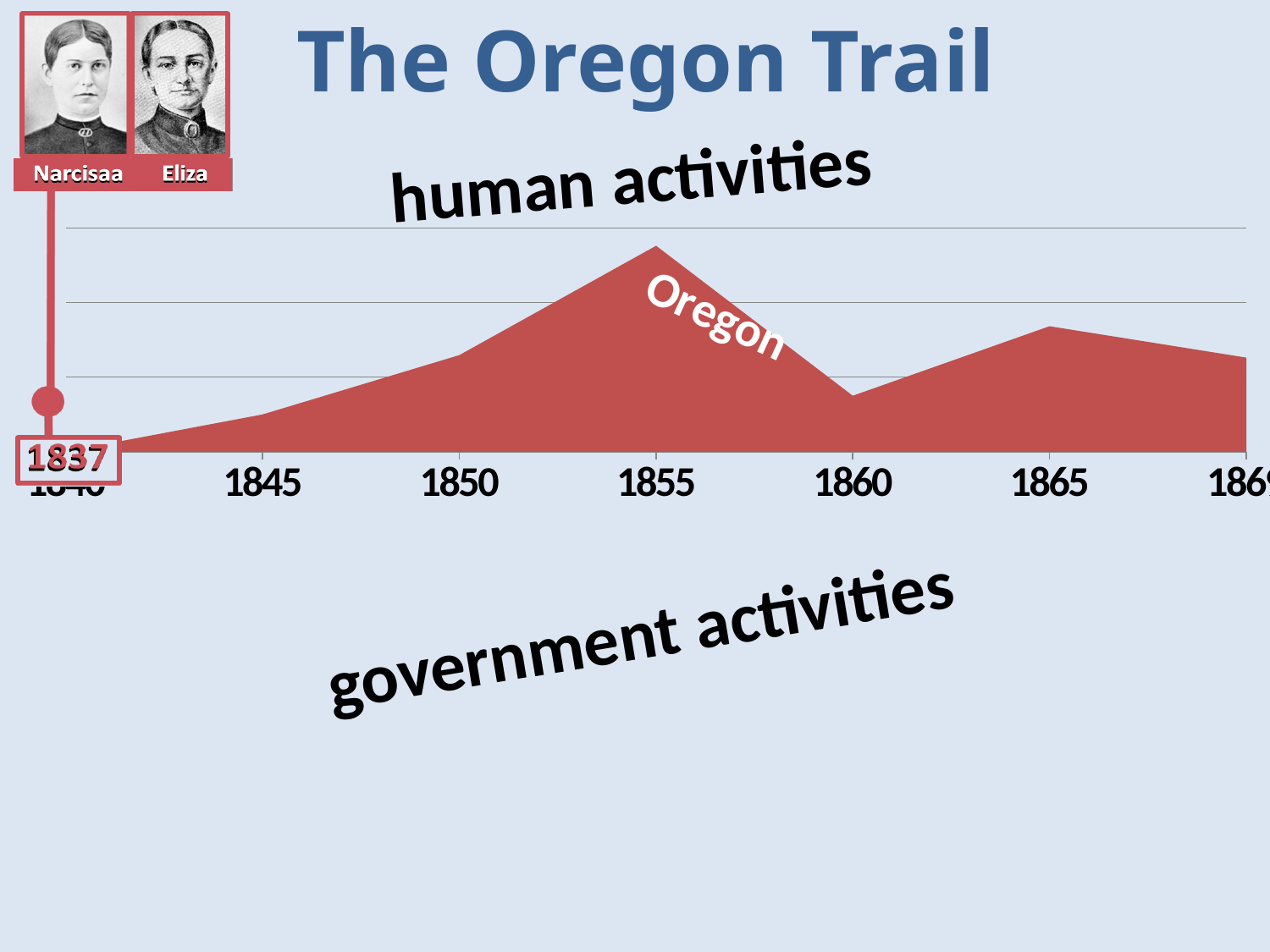
Does the Oregon series rise or fall between 1855 and 1860? fall Which year has the larger value for the Oregon series, 1845 or 1860? 1860 Which year has the larger value for the Oregon series, 1855 or 1865? 1855 What is the name of the series plotted in the area chart? Oregon Does the Oregon series rise or fall between 1860 and 1865? rise Does the Oregon series rise or fall between 1840 and 1855? rise Which year has the larger value for the Oregon series, 1860 or 1865? 1865 What kind of chart is shown on the slide? area chart What is the title of the slide containing the chart? The Oregon Trail In which year does the Oregon series reach its highest value? 1855